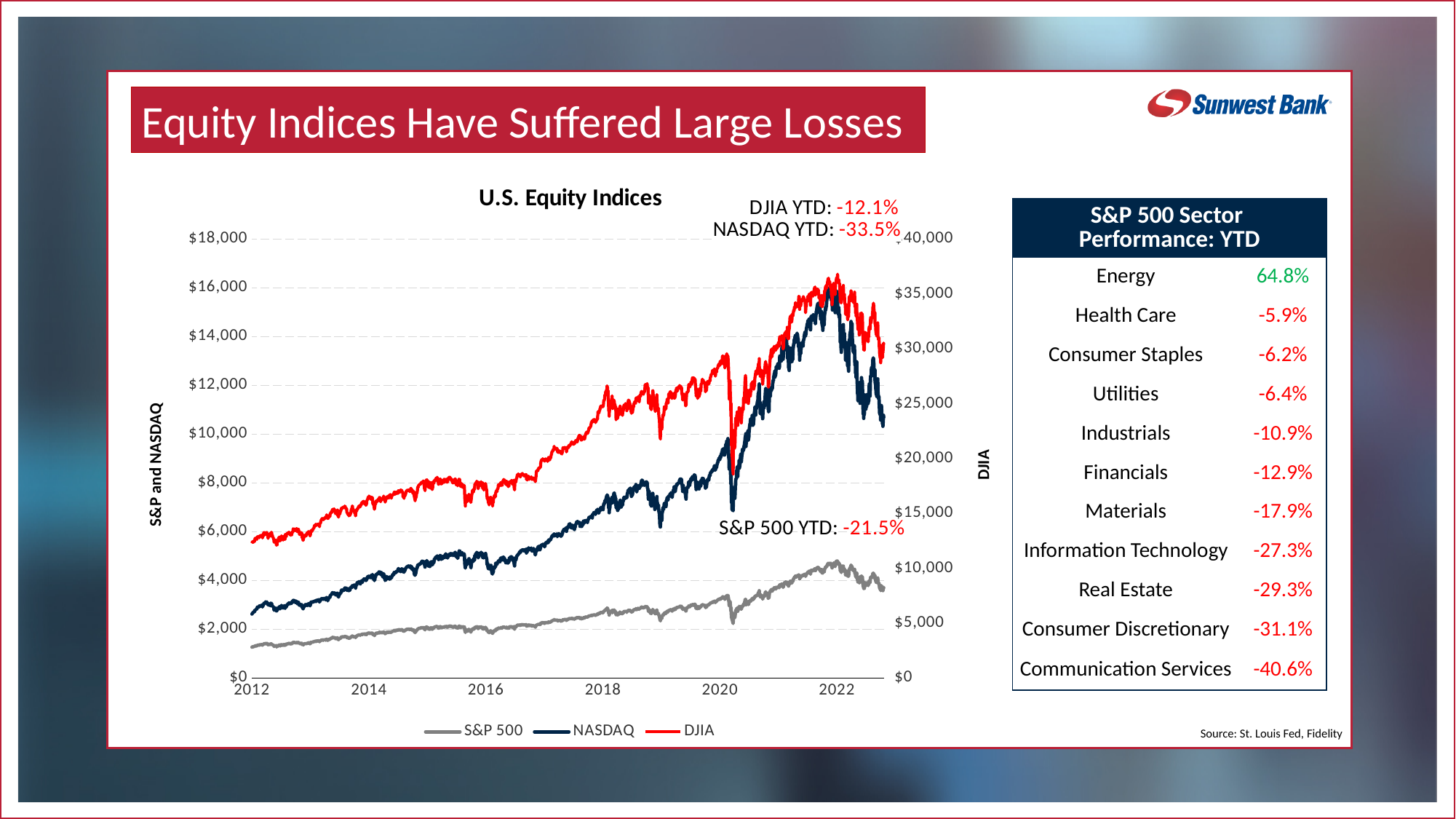
How many series does the legend of the U.S. Equity Indices chart list? 3 On the U.S. Equity Indices chart, is the NASDAQ value at the start of 2012 greater or less than $4,000? less On the U.S. Equity Indices chart, which index has the smaller YTD decline, DJIA or S&P 500? DJIA What is the S&P 500 YTD figure annotated on the U.S. Equity Indices chart? -21.5% On the U.S. Equity Indices chart, what colour is the DJIA line? Red What kind of chart is the U.S. Equity Indices chart? Line chart What is the DJIA YTD figure annotated on the U.S. Equity Indices chart? -12.1% What is the NASDAQ YTD figure annotated on the U.S. Equity Indices chart? -33.5% On the U.S. Equity Indices chart, which index shows the largest YTD decline? NASDAQ On the U.S. Equity Indices chart, by how many percentage points does the NASDAQ YTD decline exceed the S&P 500 YTD decline? 12.0 percentage points On the U.S. Equity Indices chart, does the S&P 500 line overall rise or fall from 2012 to 2022? Rise On the U.S. Equity Indices chart, which axis is the DJIA series plotted against? The right axis (DJIA)